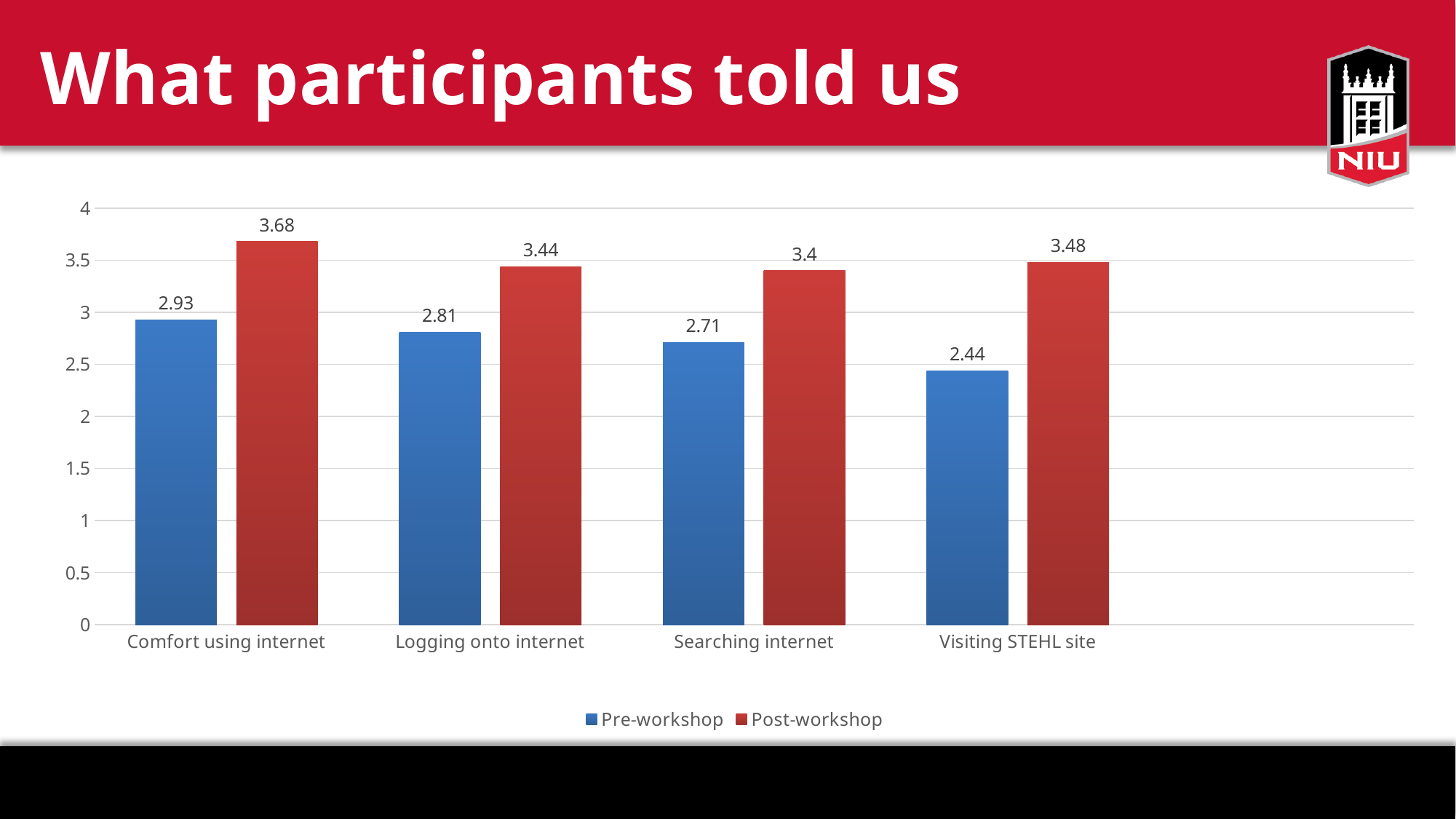
What is the difference between the Pre-workshop values for Comfort using internet and Logging onto internet? 0.12 Which category has the highest Post-workshop value? Comfort using internet Which category has the lowest Pre-workshop value? Visiting STEHL site What is the Pre-workshop value for Comfort using internet? 2.93 Which is larger: the Pre-workshop value for Searching internet or the Pre-workshop value for Logging onto internet? Logging onto internet How many categories are shown on the x axis? 4 What is the difference between the Post-workshop and Pre-workshop values for Visiting STEHL site? 1.04 Is the Post-workshop value for Logging onto internet greater or less than 3? greater How many series does the legend list? 2 What kind of chart is shown on the slide? Bar chart What is the Post-workshop value for Visiting STEHL site? 3.48 What is the Post-workshop value for Searching internet? 3.4